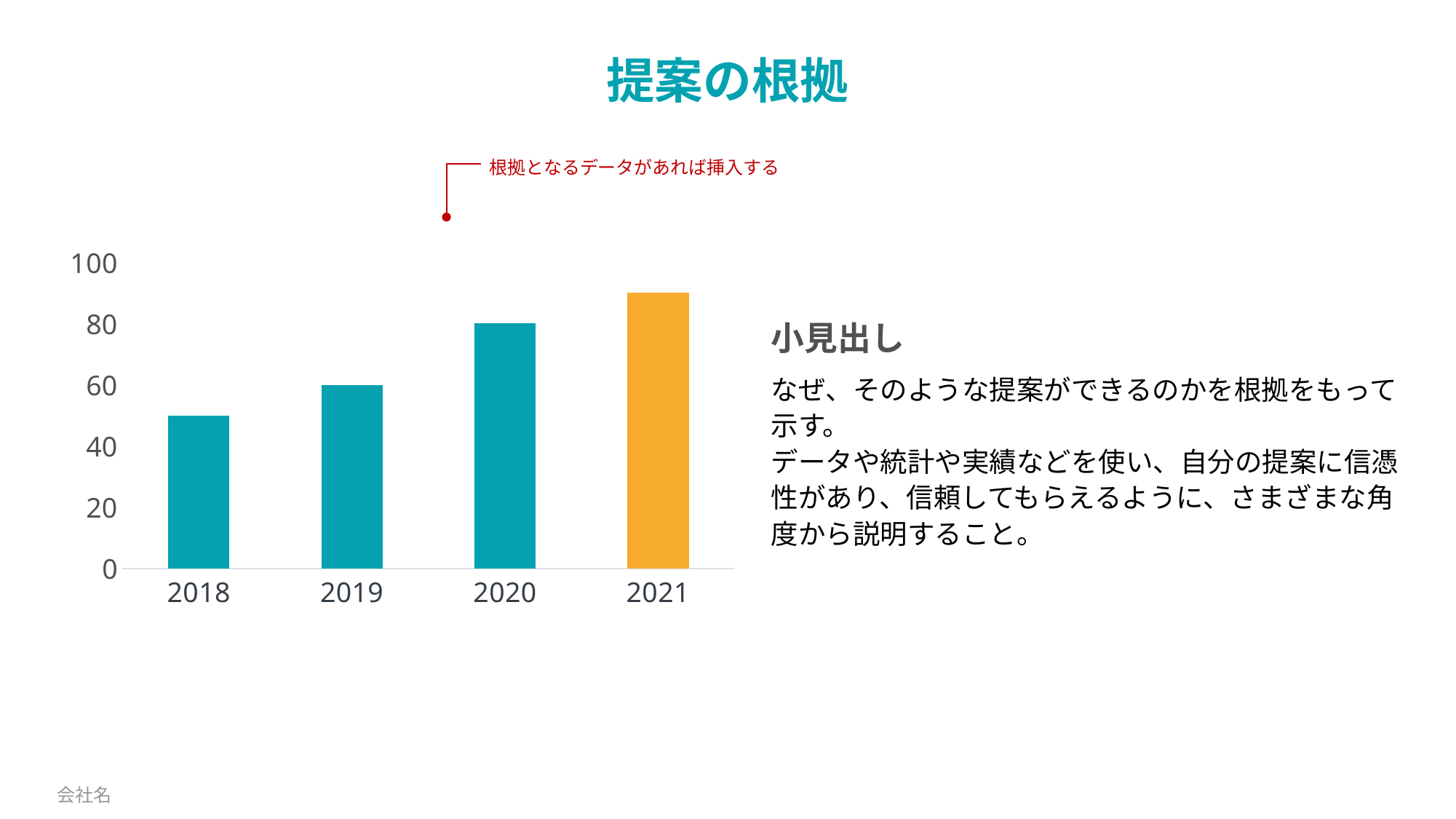
Do the values rise or fall from 2018 to 2021? rise Is the value for 2021 greater or less than 80? greater What kind of chart is shown on the slide? bar chart What is the highest value shown on the vertical axis of the chart? 100 Which is larger, the value for 2020 or the value for 2019? 2020 Which year has the lowest bar in the chart? 2018 How many years are shown on the x axis of the chart? 4 Is the value for 2018 greater or less than 40? greater Which year has the highest bar in the chart? 2021 Is the value for 2018 greater or less than 60? less Which bar in the chart is coloured orange rather than teal? 2021